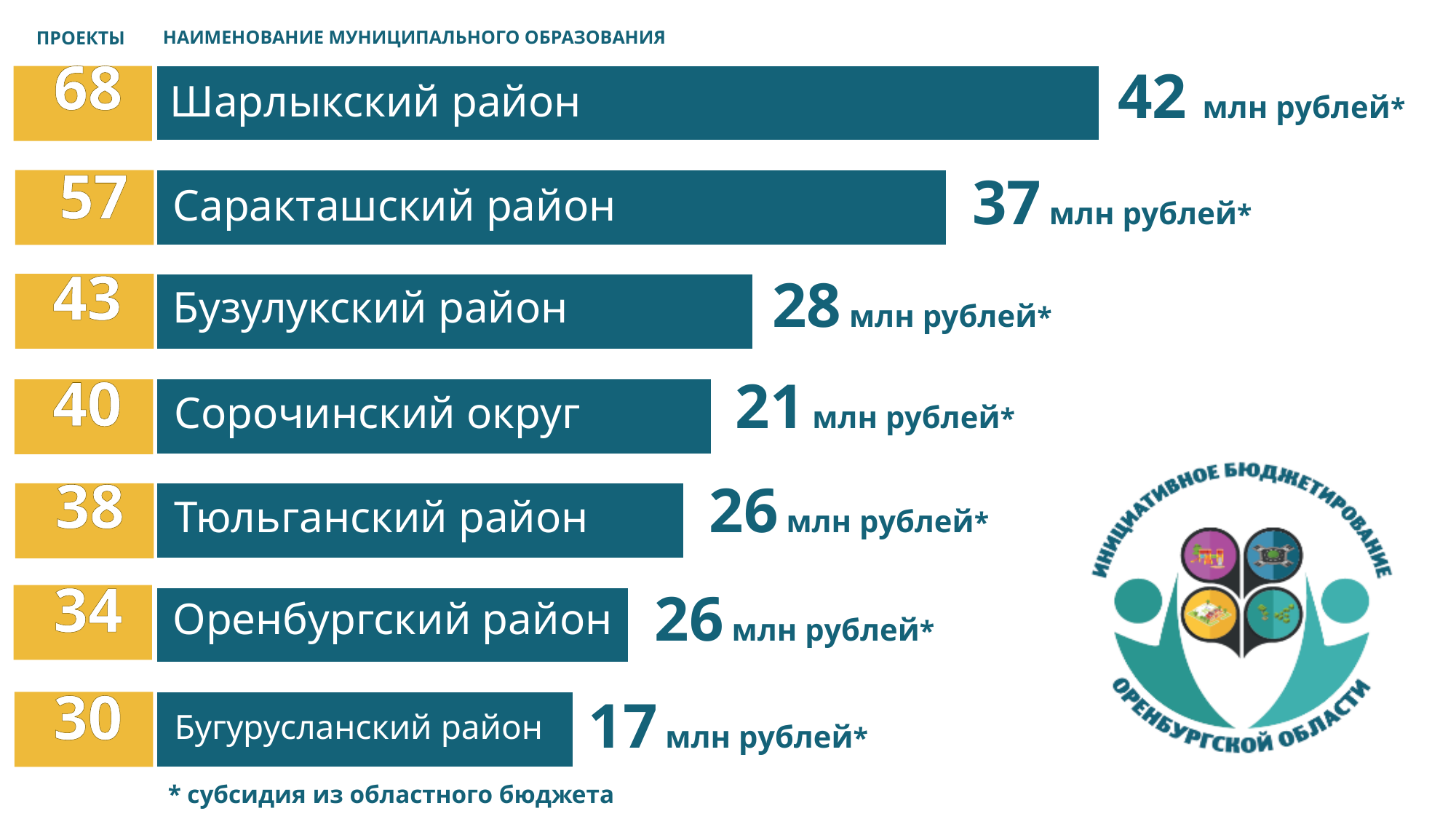
What is the subsidy amount for Сорочинский округ? 21 млн рублей Do the project counts rise or fall going down the list from top to bottom? fall Which municipality has the highest number of projects? Шарлыкский район How many projects does Шарлыкский район have? 68 What is the difference in subsidy between Саракташский район and Бузулукский район? 9 млн рублей Which has more projects, Бузулукский район or Тюльганский район? Бузулукский район What is the difference in the number of projects between Шарлыкский район and Саракташский район? 11 Which municipality has the lowest subsidy amount? Бугурусланский район According to the footnote, what does the asterisk next to the ruble amounts mean? субсидия из областного бюджета How many municipalities are listed on the slide? 7 What kind of chart is shown on the slide? bar chart What is the subsidy amount for Бугурусланский район? 17 млн рублей